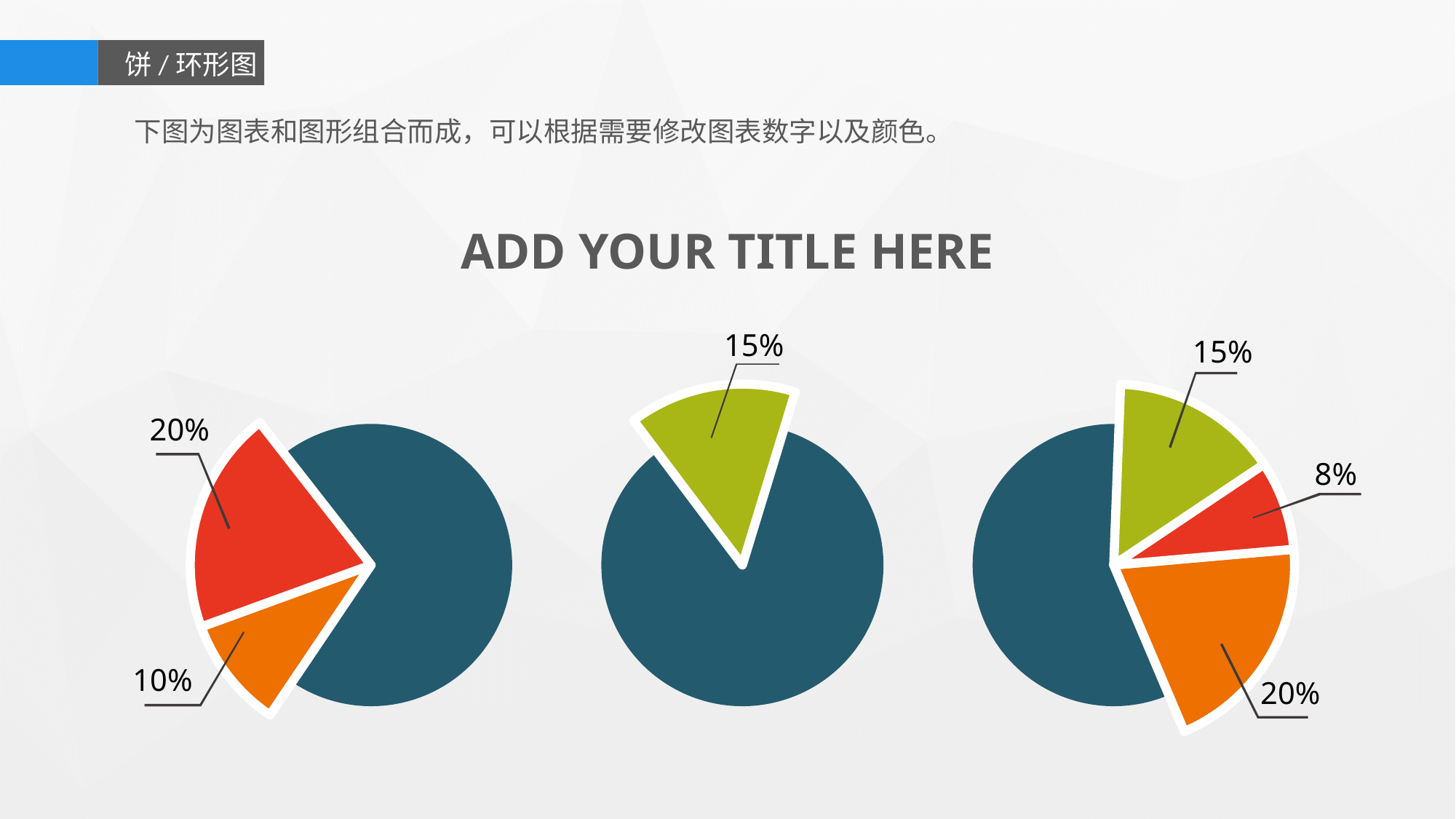
In the right pie chart, what percentage is shown for the red slice? 8% How many slices does the middle pie chart have? 2 In the right pie chart, which slice is the largest? The dark blue slice In the right pie chart, which is larger, the orange slice or the red slice? The orange slice In the left pie chart, what percentage is shown for the red slice? 20% In the left pie chart, what percentage is shown for the orange slice? 10% What kind of charts are shown on the slide? Pie charts In the middle pie chart, what percentage is shown for the green slice? 15% In the right pie chart, what percentage is shown for the orange slice? 20% What is the title text shown above the charts? ADD YOUR TITLE HERE How many pie charts are on the slide? 3 In the left pie chart, what is the difference between the red slice and the orange slice? 10%